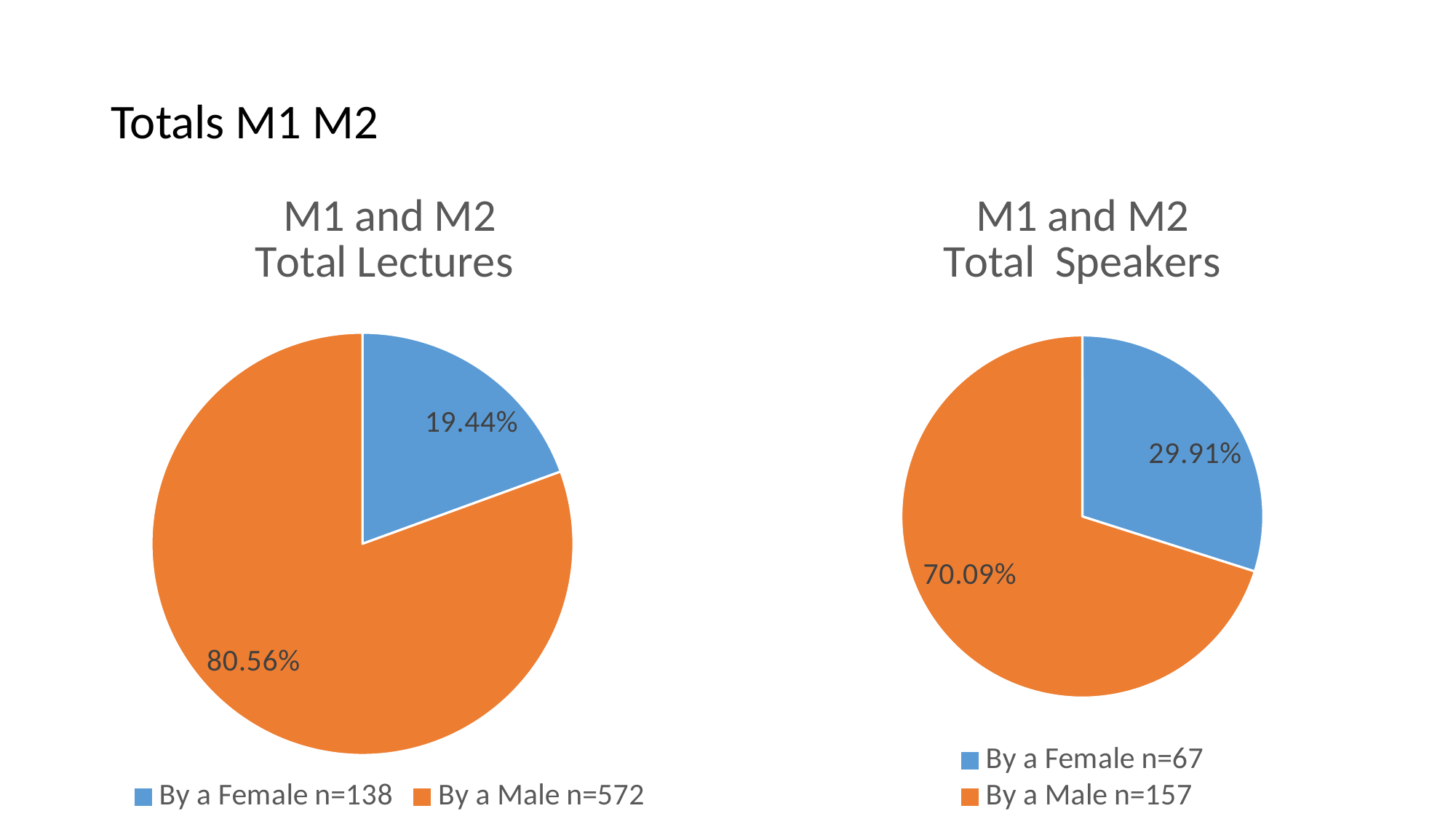
In the 'M1 and M2 Total Speakers' chart, what percentage of speakers were male? 70.09% Which is larger: the female share in the 'M1 and M2 Total Lectures' chart or the female share in the 'M1 and M2 Total Speakers' chart? M1 and M2 Total Speakers In the 'M1 and M2 Total Lectures' chart, what percentage of lectures were by a female? 19.44% How many slices does the 'M1 and M2 Total Speakers' pie chart have? 2 In the 'M1 and M2 Total Lectures' chart, what is the n value shown in the legend for 'By a Male'? 572 In the 'M1 and M2 Total Lectures' chart, which slice is the smallest? By a Female n=138 In the 'M1 and M2 Total Lectures' chart, what is the difference in percentage points between the male and female slices? 61.12 In the 'M1 and M2 Total Speakers' chart, what percentage of speakers were female? 29.91% What kind of chart is the 'M1 and M2 Total Lectures' chart? Pie chart In the 'M1 and M2 Total Speakers' chart, what colour is the 'By a Female n=67' slice? Blue In the 'M1 and M2 Total Lectures' chart, what percentage of lectures were by a male? 80.56% In the 'M1 and M2 Total Speakers' chart, which slice is the largest? By a Male n=157